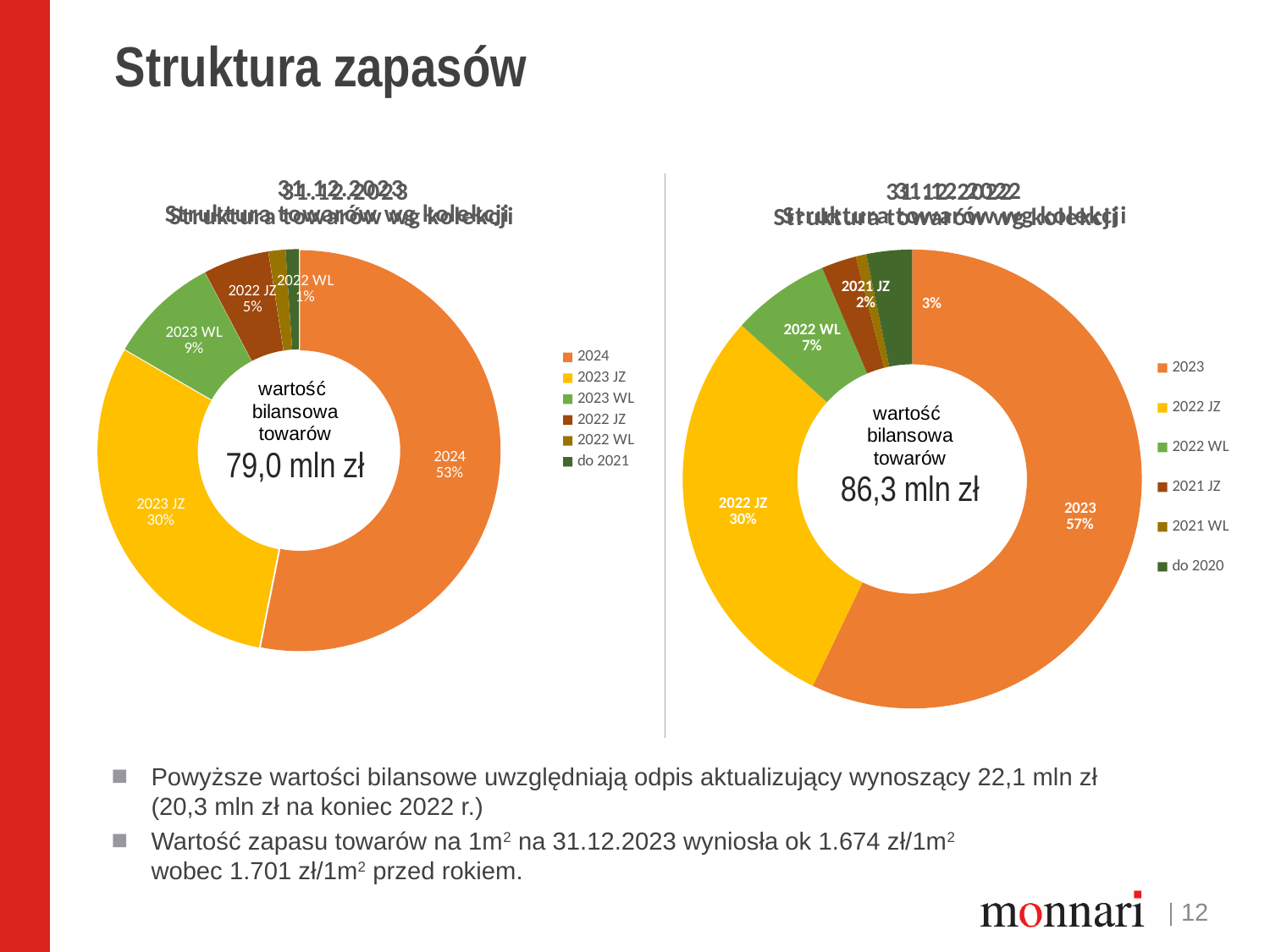
What value is printed in the centre of the right chart? 86,3 mln zł In the right chart, what percentage is shown for 2022 WL? 7% What kind of chart is the left chart on the slide? doughnut chart In the left chart, which category has the largest slice? 2024 In the right chart, which category has the largest slice? 2023 In the left chart, what share of the total does the 2024 slice represent? 53% What value is printed in the centre of the left chart? 79,0 mln zł In the right chart, what share of the total does the 2023 slice represent? 57% How many entries does the legend of the left chart list? 6 In the right chart, which slice is larger: 2022 JZ or 2022 WL? 2022 JZ In the left chart, what percentage is shown for 2023 JZ? 30% In the left chart, what is the difference in percentage points between the 2024 slice and the 2023 JZ slice? 23 percentage points